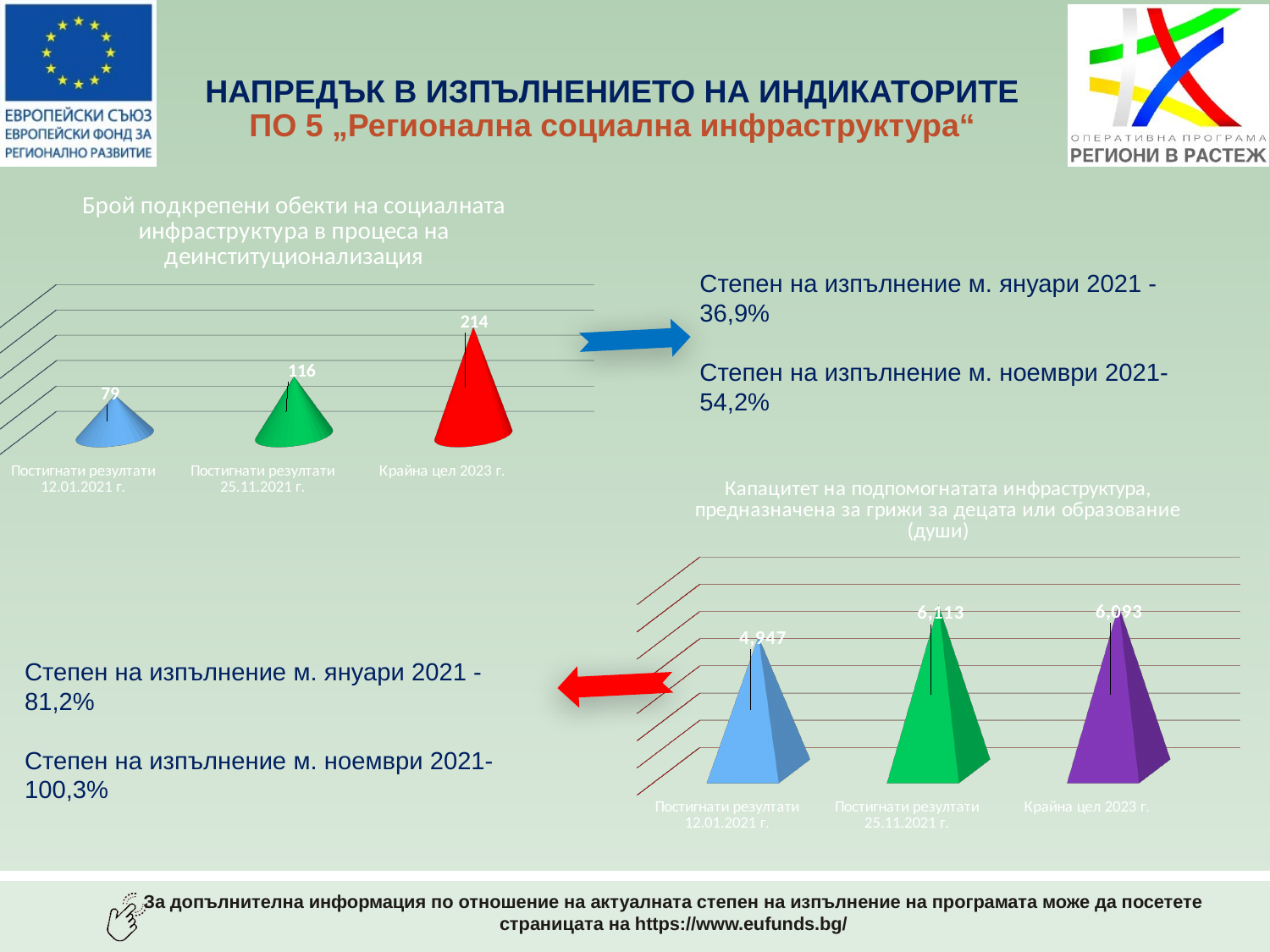
In the right chart (Капацитет на подпомогнатата инфраструктура), what is the value for Крайна цел 2023 г.? 6,093 In the left chart (Брой подкрепени обекти на социалната инфраструктура), what is the difference between Крайна цел 2023 г. and Постигнати резултати 25.11.2021 г.? 98 In the left chart (Брой подкрепени обекти на социалната инфраструктура), do the values rise or fall from left to right? rise In the right chart (Капацитет на подпомогнатата инфраструктура), what is the value for Постигнати резултати 12.01.2021 г.? 4,947 In the left chart (Брой подкрепени обекти на социалната инфраструктура), which category has the lowest value? Постигнати резултати 12.01.2021 г. How many charts are shown on the slide? 2 In the left chart (Брой подкрепени обекти на социалната инфраструктура), what is the value for Постигнати резултати 12.01.2021 г.? 79 In the right chart (Капацитет на подпомогнатата инфраструктура), how many categories are plotted? 3 In the right chart (Капацитет на подпомогнатата инфраструктура), which category has the lowest value? Постигнати резултати 12.01.2021 г. In the left chart (Брой подкрепени обекти на социалната инфраструктура), what is the value for Крайна цел 2023 г.? 214 In the left chart (Брой подкрепени обекти на социалната инфраструктура), what is the value for Постигнати резултати 25.11.2021 г.? 116 In the right chart (Капацитет на подпомогнатата инфраструктура), what is the value for Постигнати резултати 25.11.2021 г.? 6,113